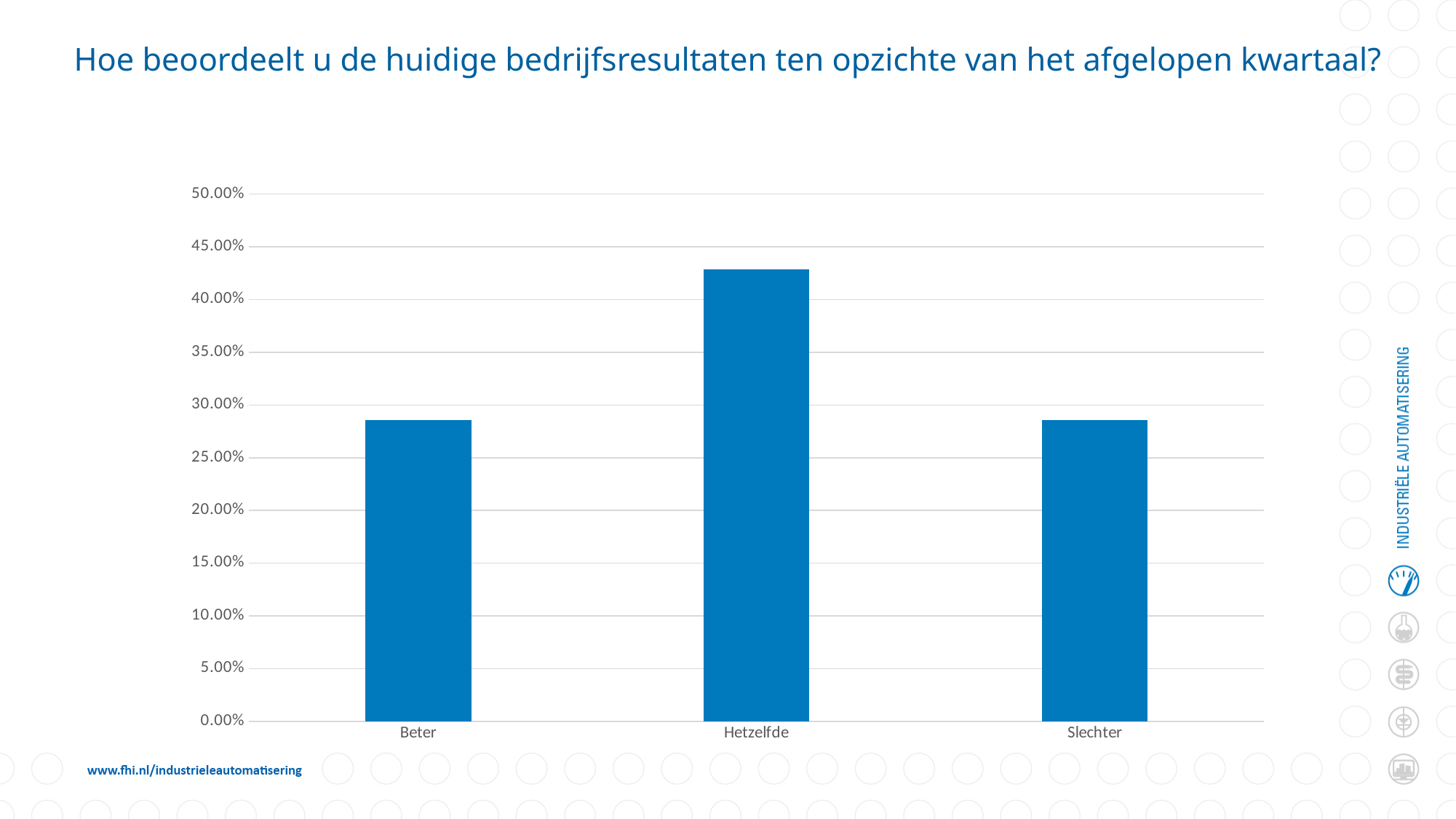
How many categories are shown on the x axis of the chart? 3 Is the value for Hetzelfde greater or less than 40.00%? greater Which is larger, the value for Hetzelfde or the value for Beter? Hetzelfde What kind of chart is shown on the slide? bar chart What is the highest tick value shown on the y axis of the chart? 50.00% Is the value for Beter greater or less than 30.00%? less Is the value for Slechter greater or less than 25.00%? greater Which category has the highest value in the chart? Hetzelfde Which is larger, the value for Slechter or the value for Hetzelfde? Hetzelfde What is the title of the slide containing the chart? Hoe beoordeelt u de huidige bedrijfsresultaten ten opzichte van het afgelopen kwartaal?